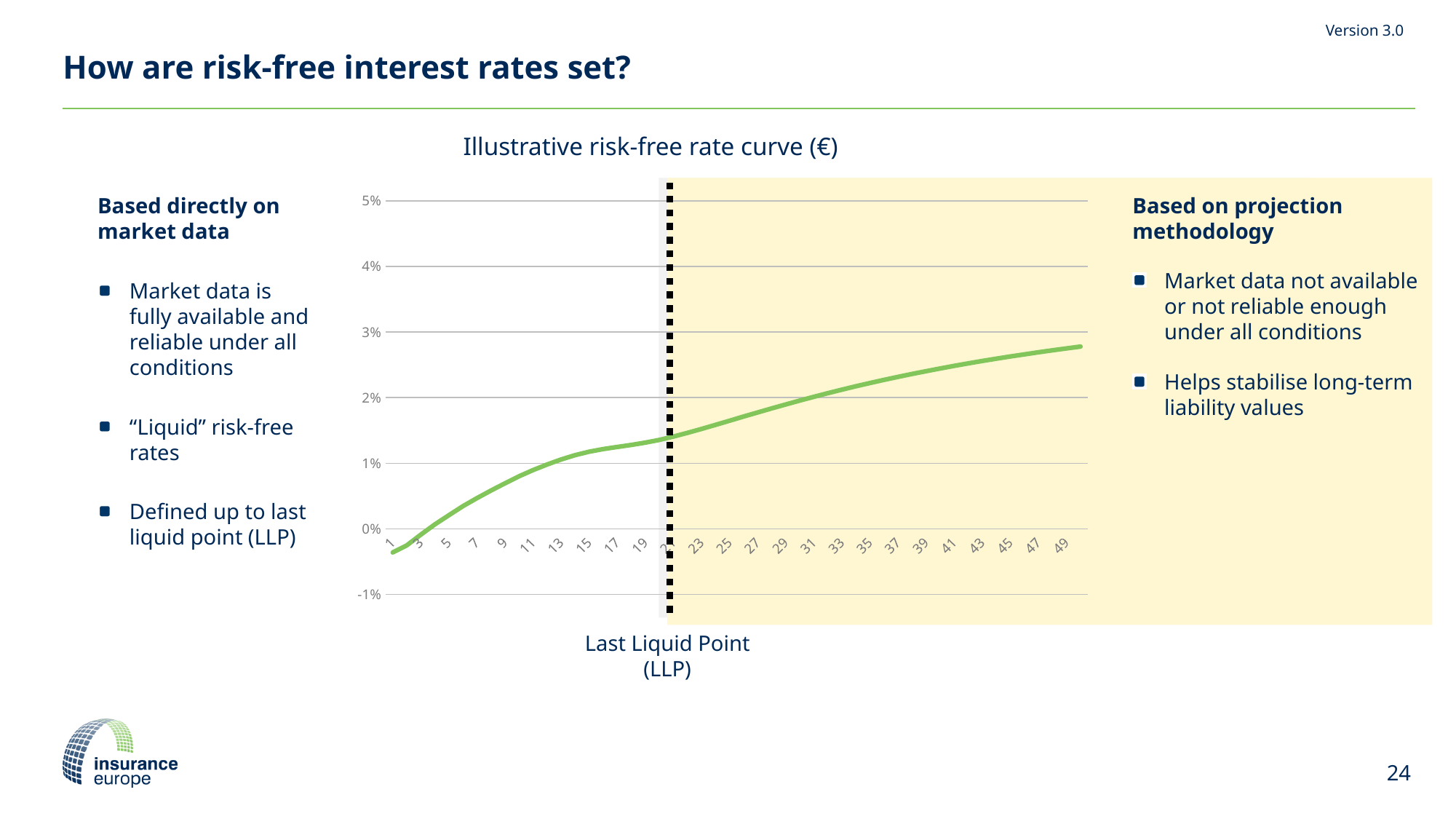
Is the value of the curve at x = 1 greater or less than 0%? less What is the title of the chart? Illustrative risk-free rate curve (€) How many tick labels are shown on the x axis? 25 Do the values on the risk-free rate curve rise or fall as you move along the x axis from 1 to 49? Rise Is the value of the curve at x = 41 greater or less than 2%? greater Is the value of the curve at x = 49 greater or less than 2%? greater At which x-axis value does the curve reach its lowest point? 1 What is the highest tick value shown on the y axis? 5% What kind of chart is shown on the slide? Line chart